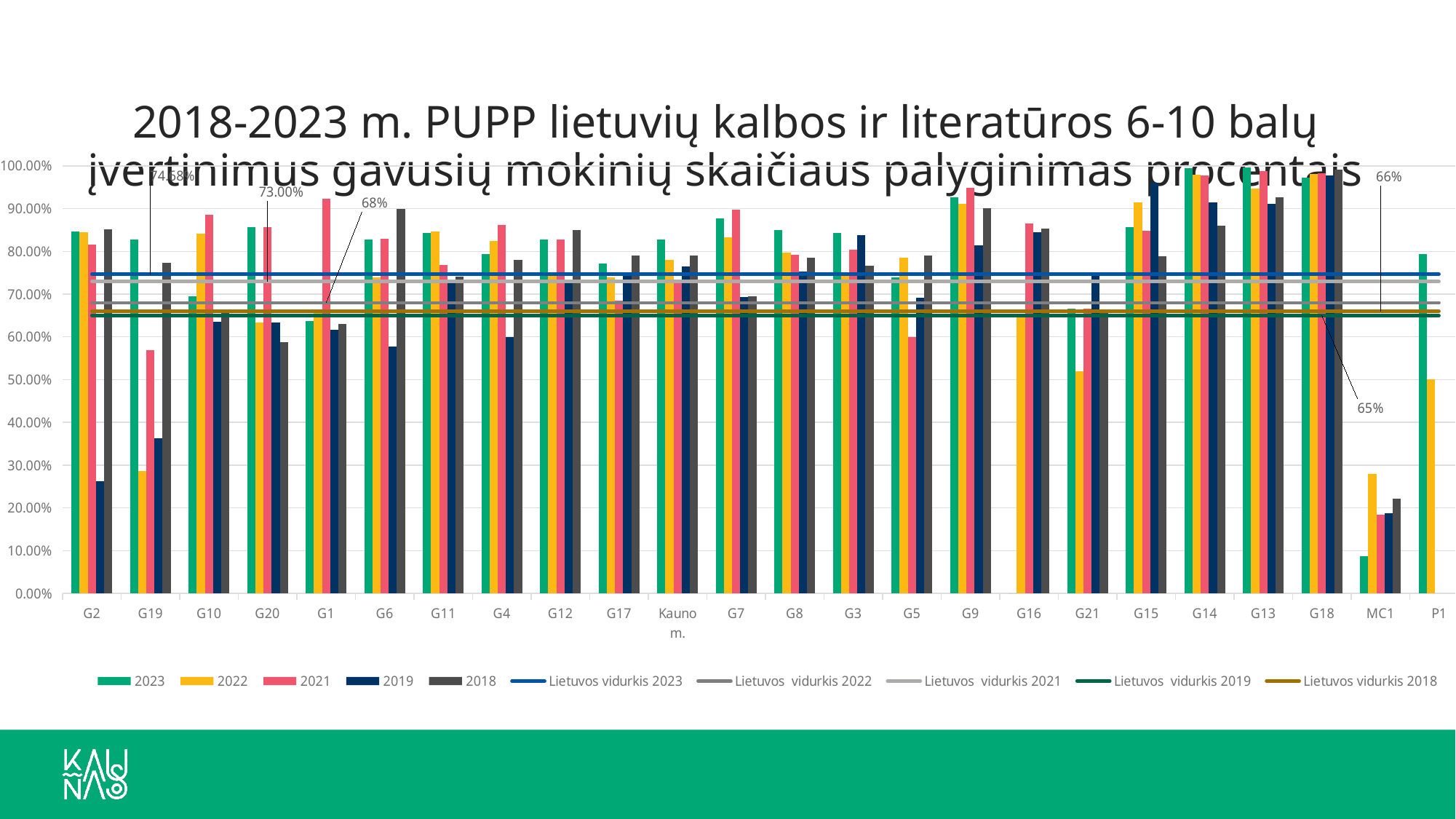
How many series does the legend list? 10 What kind of chart is shown on the slide? combination bar and line chart Is the value for MC1 in the 2023 series greater or less than 20%? less How many categories are shown along the x axis? 24 What value is labelled for the Lietuvos vidurkis 2022 line? 68% Is the value for G14 in the 2023 series greater or less than 90%? greater What value is labelled for the Lietuvos vidurkis 2023 line? 74.68% Which series is shown in green bars according to the legend? 2023 For G10, which is larger: the 2021 value or the 2019 value? 2021 Is the value for G19 in the 2019 series greater or less than 40%? less What value is labelled for the Lietuvos vidurkis 2021 line? 73.00%